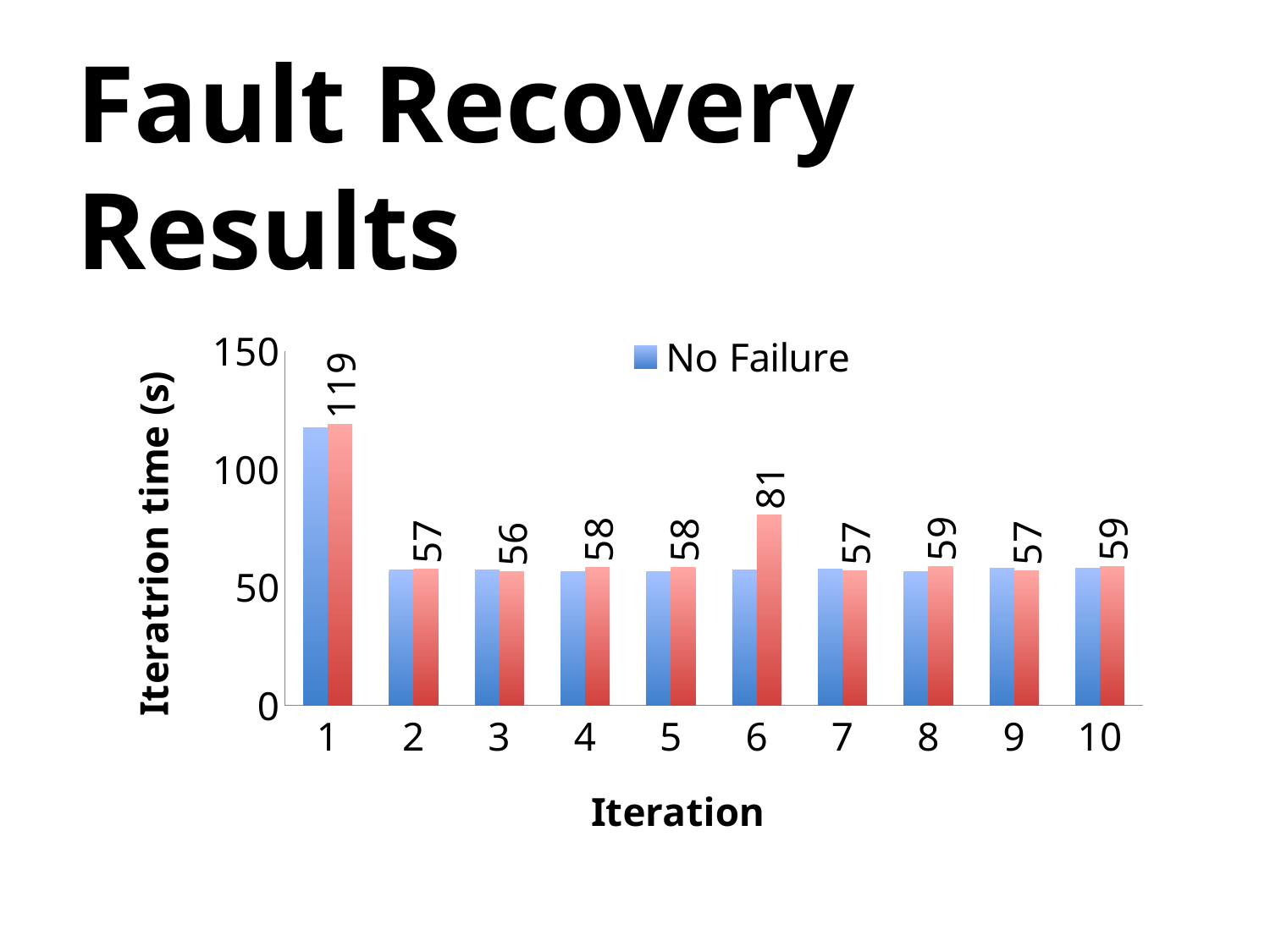
What kind of chart is shown on the slide? bar chart How many series does the chart's legend list? 1 What is the labelled value of the red bar at iteration 1? 119 What is the title of the y axis of the chart? Iteratrion time (s) What is the labelled value of the red bar at iteration 6? 81 Which has the larger labelled red bar value, iteration 6 or iteration 7? iteration 6 What is the labelled value of the red bar at iteration 3? 56 At which iteration is the labelled red bar highest? 1 At which iteration is the labelled red bar lowest? 3 What is the difference between the labelled red bar values at iteration 1 and iteration 6? 38 How many iterations are shown on the x axis of the chart? 10 Is the No Failure value at iteration 1 greater or less than 100? greater